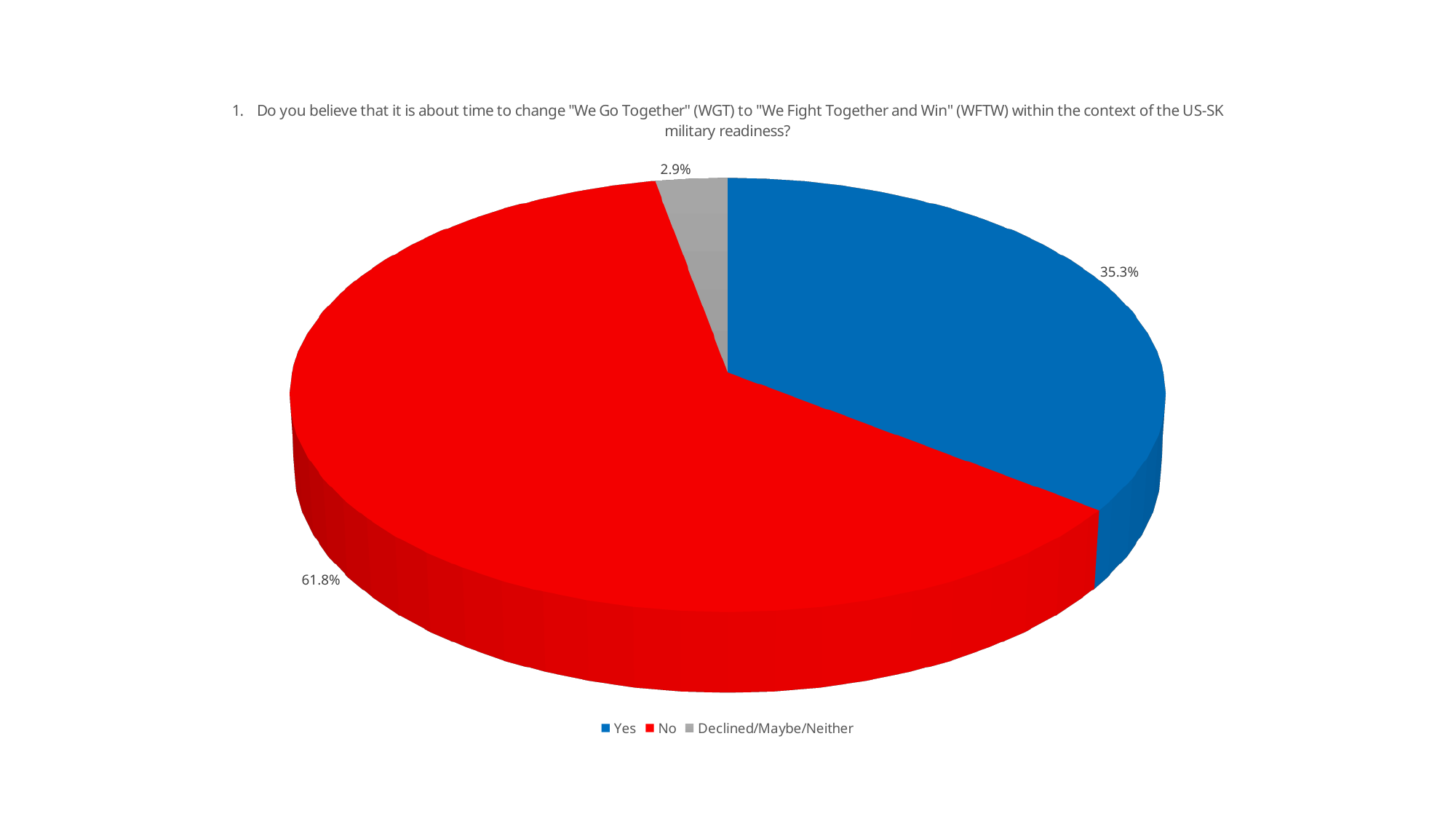
Which response has the smallest share of the pie? Declined/Maybe/Neither What percentage of respondents answered "No"? 61.8% Which is larger, the share for "Yes" or the share for "Declined/Maybe/Neither"? Yes What colour is the "Yes" slice? Blue What percentage of respondents are in the "Declined/Maybe/Neither" category? 2.9% What colour is the "No" slice? Red What is the combined share of "Yes" and "No" responses? 97.1% What is the difference in percentage points between the "No" and "Yes" shares? 26.5 What percentage of respondents answered "Yes"? 35.3% Which response has the largest share of the pie? No How many categories does the pie chart show? 3 What kind of chart is shown on the slide? Pie chart